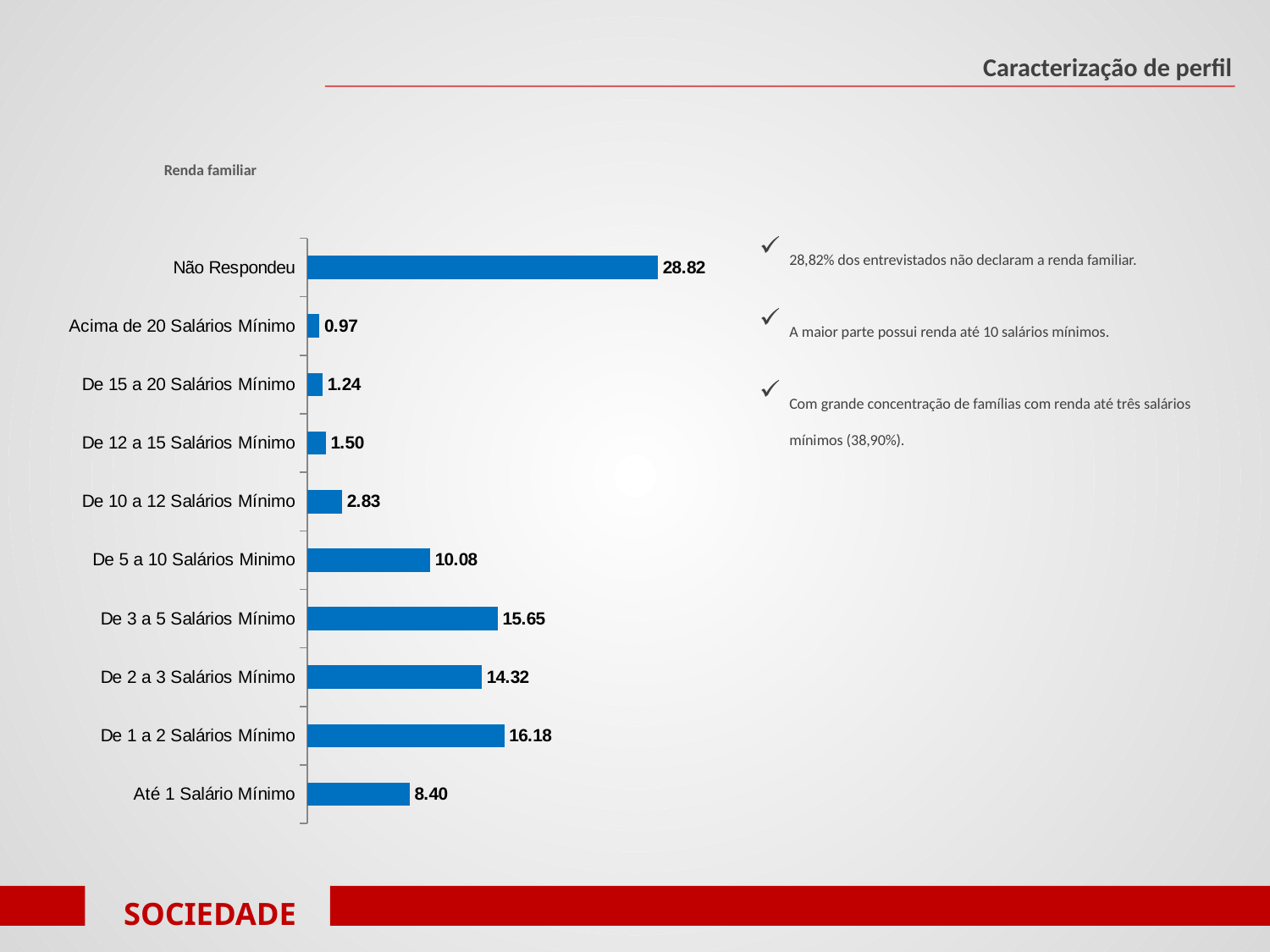
How many categories are shown in the chart? 10 What is the difference between 'De 3 a 5 Salários Mínimo' and 'De 2 a 3 Salários Mínimo'? 1.33 What is the value for 'De 1 a 2 Salários Mínimo'? 16.18 Which category has the lowest value? Acima de 20 Salários Mínimo Which is larger, 'De 1 a 2 Salários Mínimo' or 'De 3 a 5 Salários Mínimo'? De 1 a 2 Salários Mínimo What is the value for 'Até 1 Salário Mínimo'? 8.40 What is the value for 'Não Respondeu'? 28.82 What is the value for 'De 10 a 12 Salários Mínimo'? 2.83 What kind of chart is this? Bar chart Which category has the highest value? Não Respondeu What is the title of the chart? Renda familiar What is the difference between 'Não Respondeu' and 'De 5 a 10 Salários Minimo'? 18.74